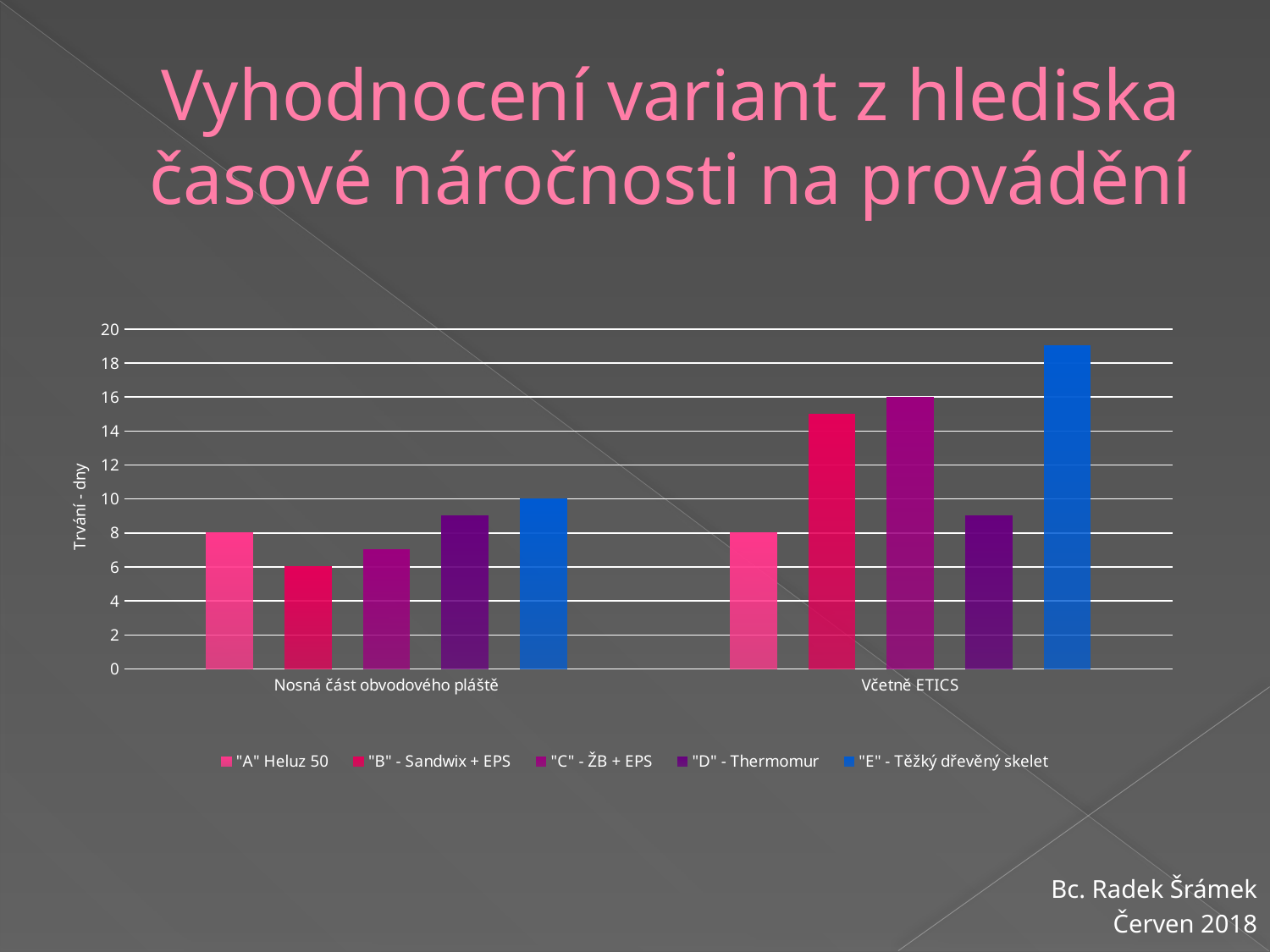
What is the label of the vertical axis? Trvání - dny How many categories are shown on the x axis? 2 Is the value for "D" - Thermomur in the Včetně ETICS category greater or less than 10? less What is the value for "E" - Těžký dřevěný skelet in the Nosná část obvodového pláště category? 10 Which series has the highest value in the Včetně ETICS category? "E" - Těžký dřevěný skelet What is the value for "B" - Sandwix + EPS in the Nosná část obvodového pláště category? 6 Which series has the lowest value in the Nosná část obvodového pláště category? "B" - Sandwix + EPS Is the value for "E" - Těžký dřevěný skelet in the Včetně ETICS category greater or less than 18? greater What is the value for "A" Heluz 50 in the Nosná část obvodového pláště category? 8 What kind of chart is shown on the slide? bar chart What is the value for "C" - ŽB + EPS in the Včetně ETICS category? 16 How many series does the legend list? 5